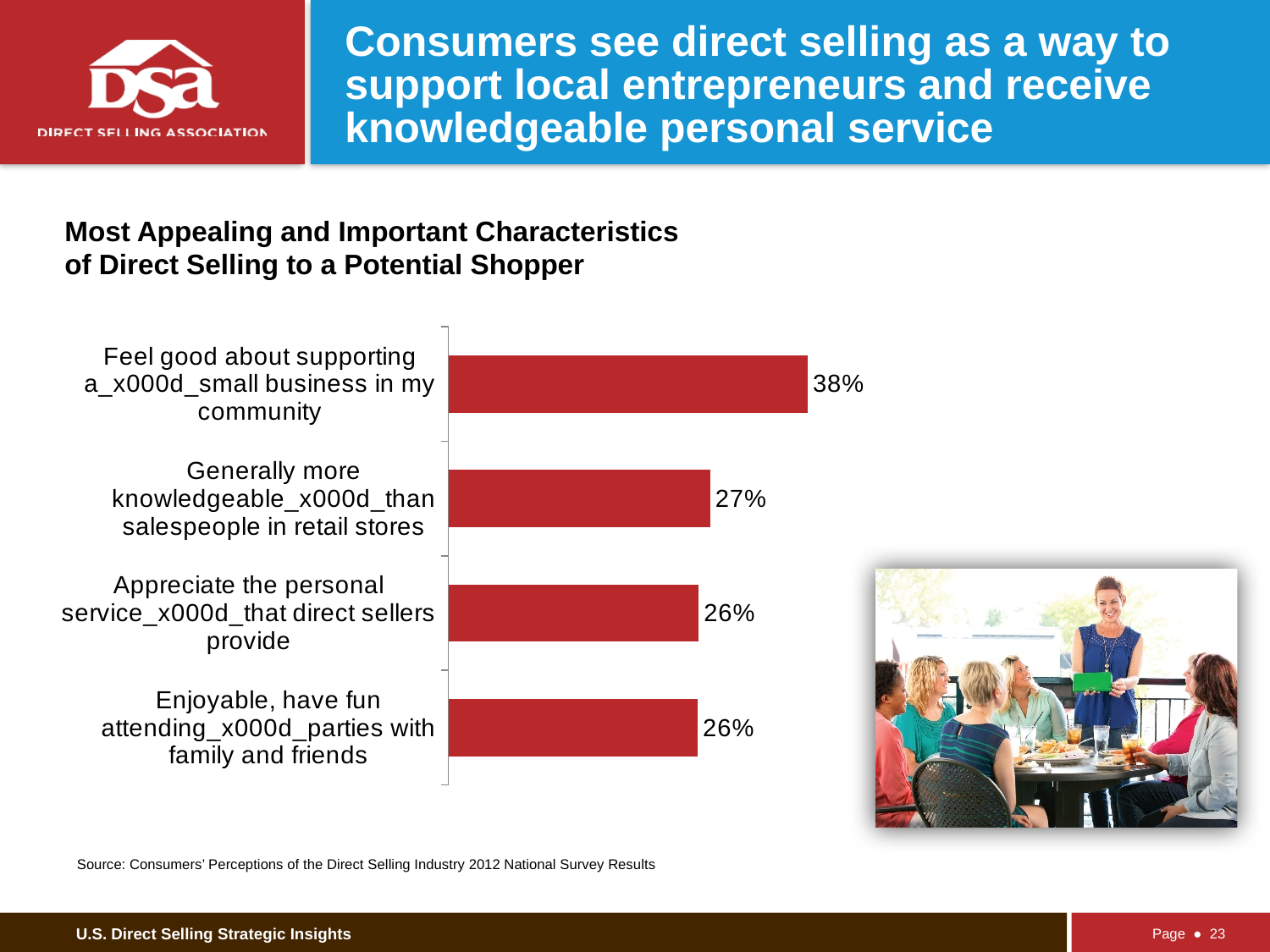
What is the title of the chart? Most Appealing and Important Characteristics of Direct Selling to a Potential Shopper Which characteristic has the highest value in the chart? Feel good about supporting a small business in my community What kind of chart is shown on the slide? Bar chart How many categories are shown in the chart? 4 What colour are the bars in the chart? Red Which is larger: the value for "Feel good about supporting a small business in my community" or the value for "Enjoyable, have fun attending parties with family and friends"? Feel good about supporting a small business in my community What is the value for "Enjoyable, have fun attending parties with family and friends"? 26% What is the value for "Appreciate the personal service that direct sellers provide"? 26% What percentage of respondents chose "Feel good about supporting a small business in my community"? 38% What is the difference between the value for "Feel good about supporting a small business in my community" and the value for "Appreciate the personal service that direct sellers provide"? 12% What is the difference between the value for "Feel good about supporting a small business in my community" and the value for "Generally more knowledgeable than salespeople in retail stores"? 11% What is the value for "Generally more knowledgeable than salespeople in retail stores"? 27%